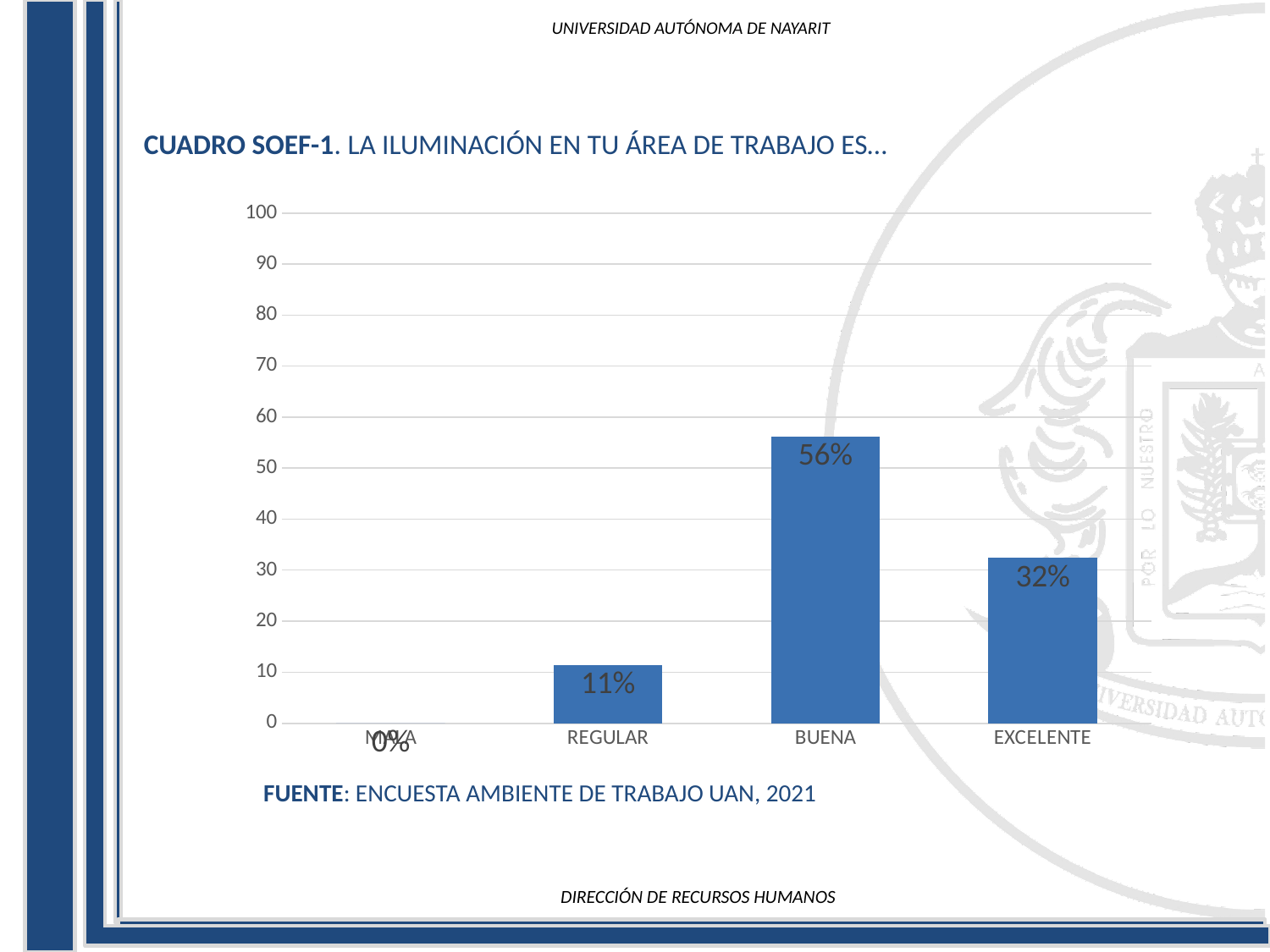
Which category has the highest value? BUENA Is the value for BUENA greater or less than 50? greater Is the value for REGULAR greater or less than 20? less What type of chart is shown on the slide? bar chart What is the value for EXCELENTE? 32% What is the difference between the values for BUENA and EXCELENTE? 24% What is the value for REGULAR? 11% Which is larger, the value for REGULAR or the value for EXCELENTE? EXCELENTE What is the source cited below the chart? ENCUESTA AMBIENTE DE TRABAJO UAN, 2021 How many categories are shown on the x axis? 4 What is the difference between the values for EXCELENTE and REGULAR? 21% What is the value for BUENA? 56%